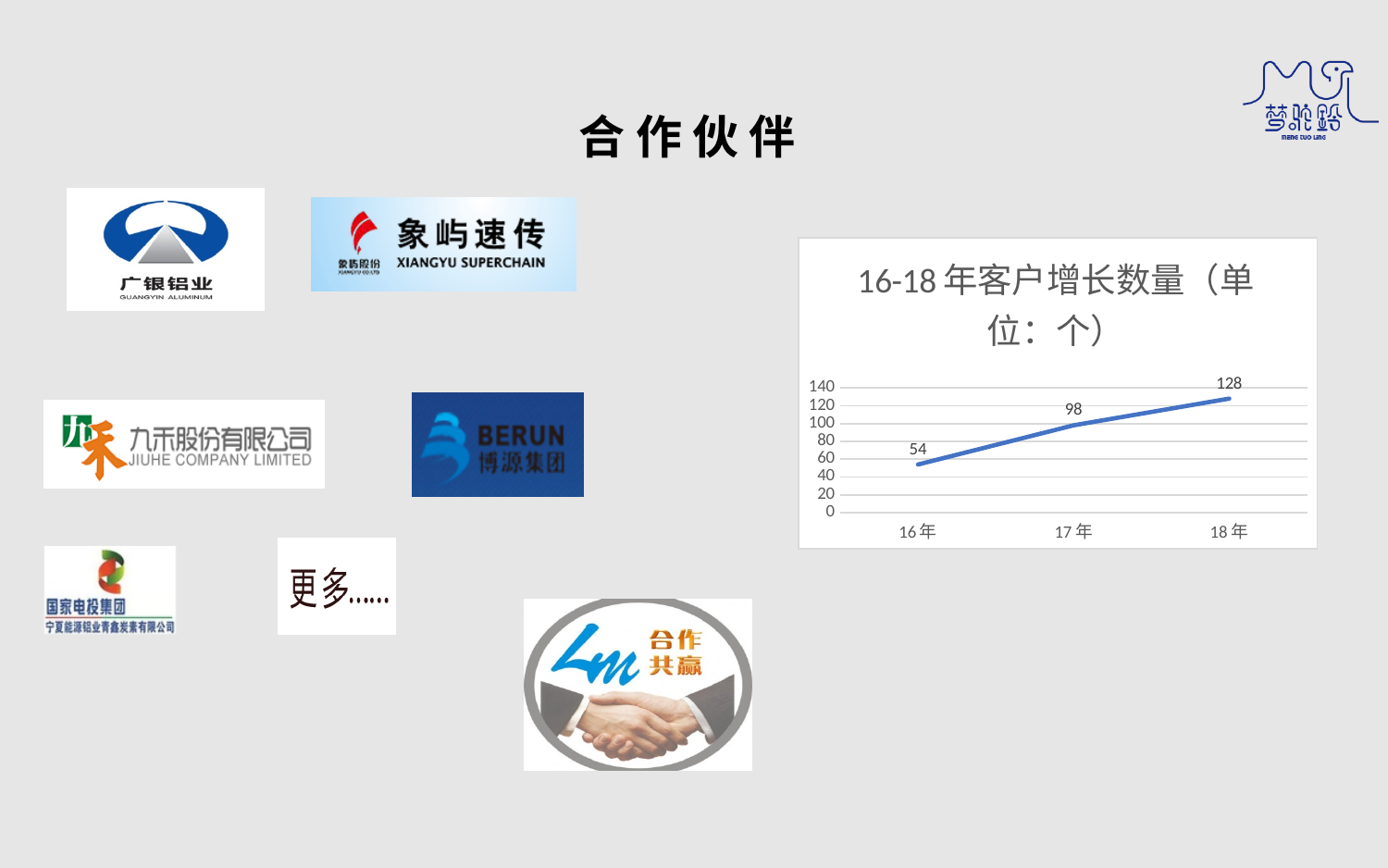
Which year has the lowest value in the chart? 16年 Which is larger, the value for 17年 or the value for 18年? 18年 What kind of chart is shown on the slide? line chart What is the value for 18年 in the chart? 128 How many data points are plotted in the chart? 3 What is the difference between the values for 17年 and 16年? 44 What is the value for 17年 in the chart? 98 What is the difference between the values for 18年 and 16年? 74 Do the values rise or fall from 16年 to 18年? rise Which year has the highest value in the chart? 18年 Is the value for 17年 greater or less than 100? less What is the value for 16年 in the chart? 54